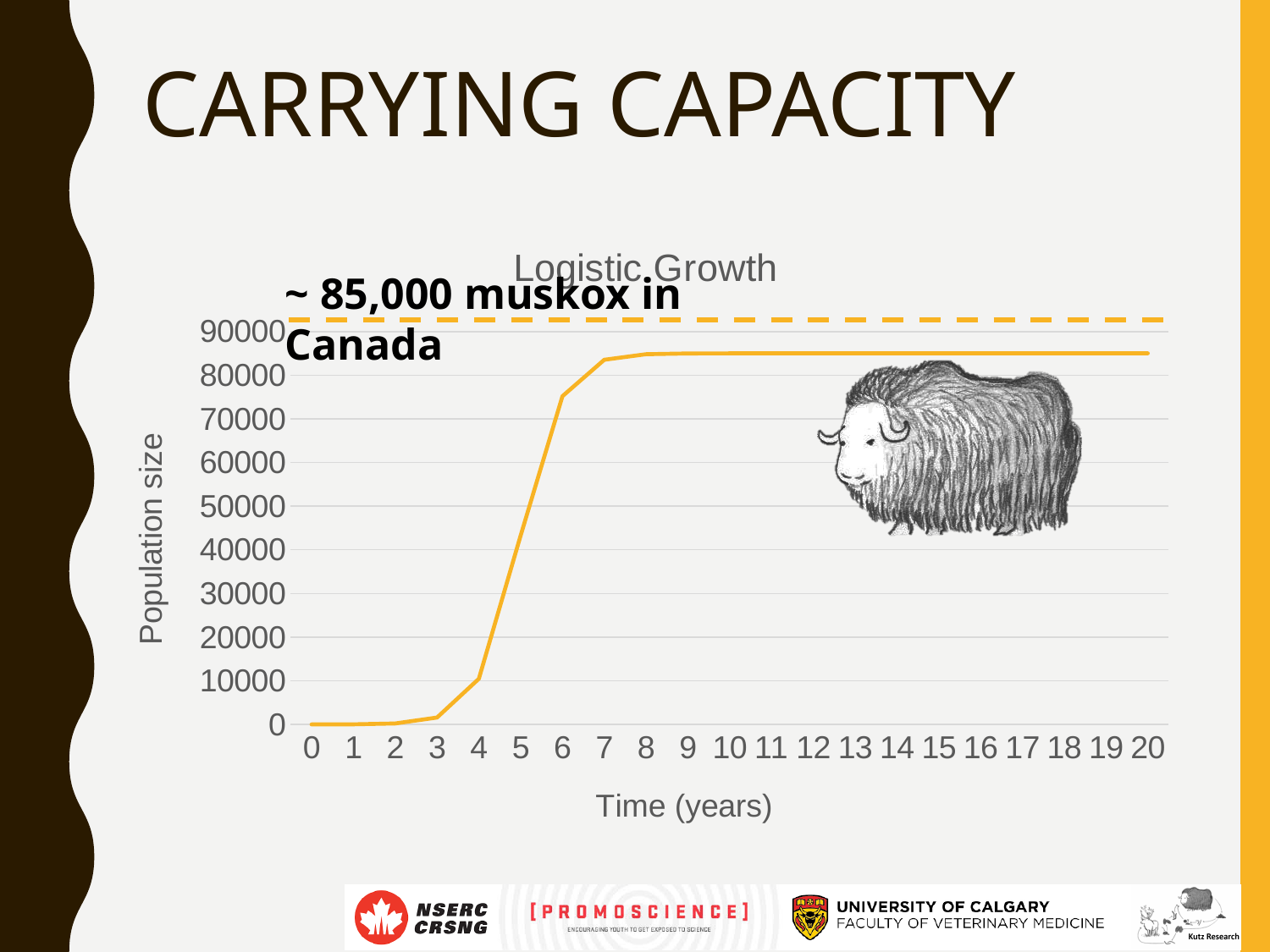
Is the population size at year 7 greater or less than 80000? greater Which has the larger population size, year 4 or year 6? year 6 What kind of chart is shown on the slide? line chart What is the label of the x axis? Time (years) How does the population size change as time increases from year 0 to year 20? rises steeply then levels off Is the population size at year 10 greater or less than 90000? less Which has the larger population size, year 3 or year 8? year 8 How many year values are marked on the x axis? 21 Is the population size at year 15 greater or less than 80000? greater What is the title of the chart? Logistic Growth